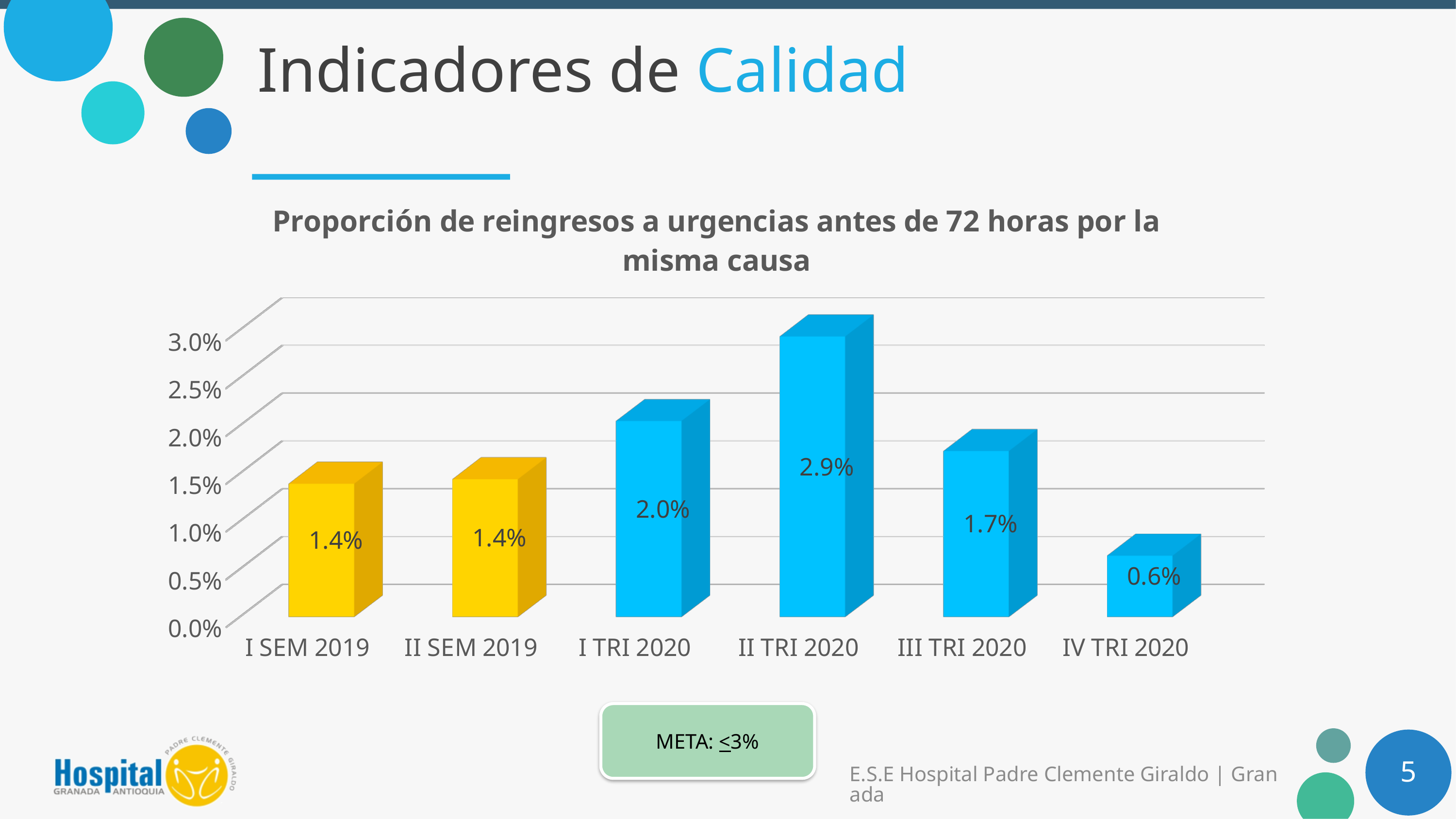
What is the value for I TRI 2020? 2.0% How many categories are shown on the x axis? 6 Which category has the highest value? II TRI 2020 Which is larger, the value for I TRI 2020 or the value for III TRI 2020? I TRI 2020 What is the value for IV TRI 2020? 0.6% Which category has the lowest value? IV TRI 2020 What is the difference between the values for II TRI 2020 and IV TRI 2020? 2.3% What is the title of the chart? Proporción de reingresos a urgencias antes de 72 horas por la misma causa What kind of chart is shown on the slide? Bar chart What is the value for III TRI 2020? 1.7% What is the value for II TRI 2020? 2.9% Do the values rise or fall from II TRI 2020 to IV TRI 2020? Fall